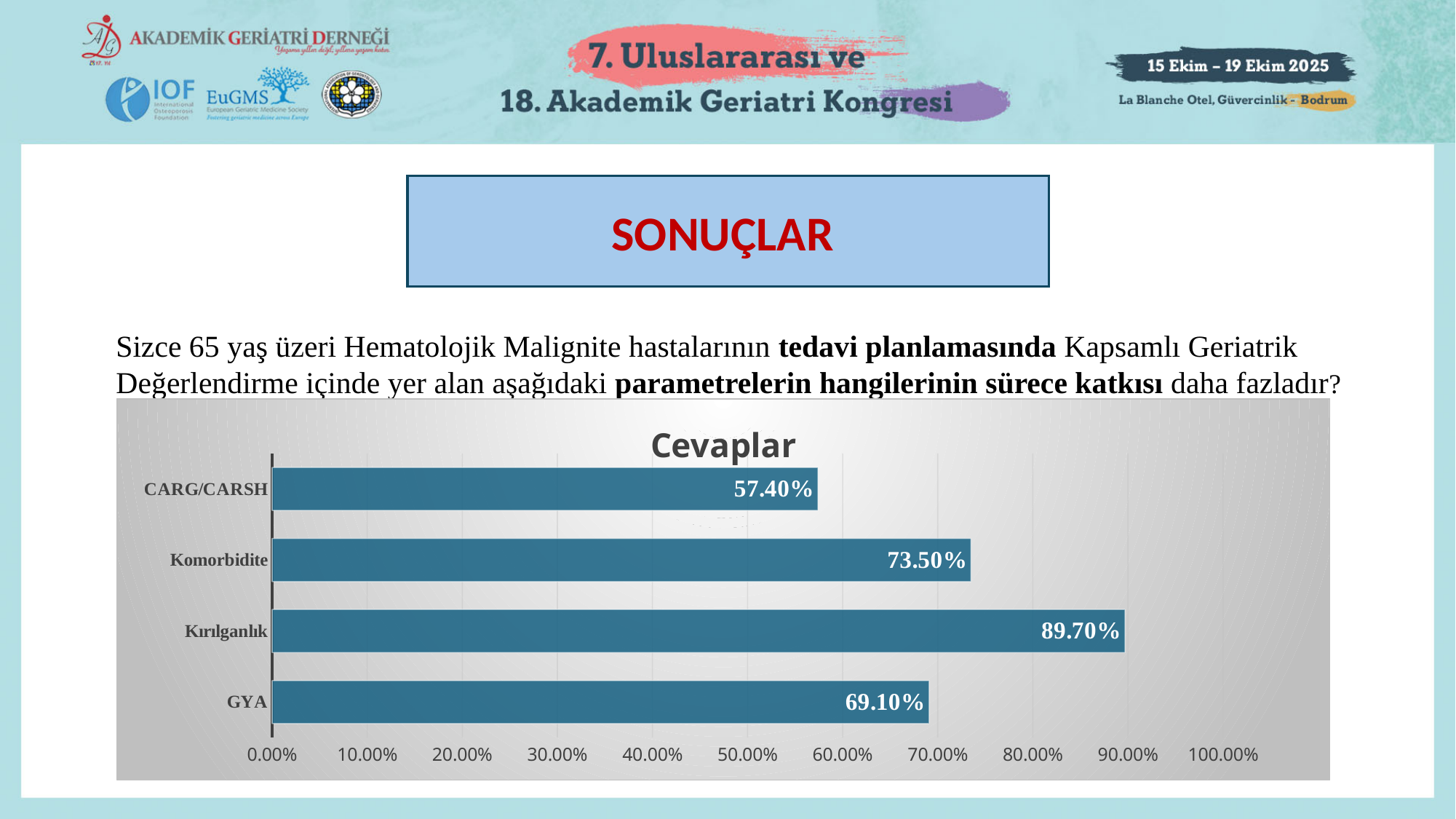
What is the difference between the values for Kırılganlık and CARG/CARSH? 32.30% What is the difference between the values for Komorbidite and GYA? 4.40% What is the value for GYA? 69.10% What is the value for Komorbidite? 73.50% Which category has the highest value? Kırılganlık What is the value for Kırılganlık? 89.70% What is the title of the chart? Cevaplar What is the value for CARG/CARSH? 57.40% How many categories are shown in the chart? 4 What kind of chart is shown on the slide? Bar chart Which category has the lowest value? CARG/CARSH Which is larger, the value for Komorbidite or the value for GYA? Komorbidite